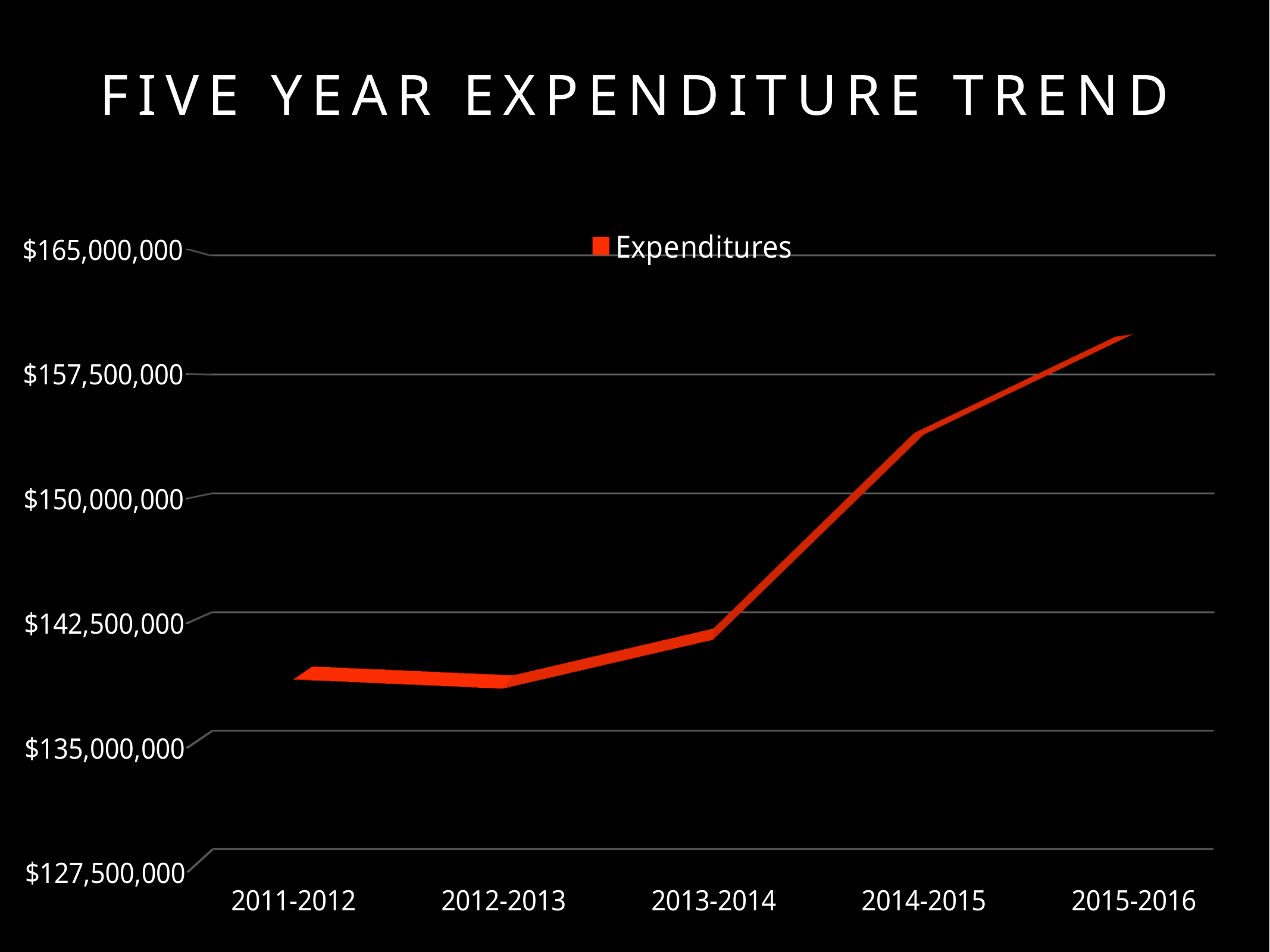
How many series does the legend list? 1 What is the title of the chart? FIVE YEAR EXPENDITURE TREND Which fiscal year has the highest expenditure? 2015-2016 What is the name of the series shown in the legend? Expenditures Do expenditures generally rise or fall from 2012-2013 to 2015-2016? rise Is the expenditure for 2014-2015 greater or less than $150,000,000? greater What kind of chart is shown on the slide? line chart Is the expenditure for 2012-2013 greater or less than $135,000,000? greater Is the expenditure for 2011-2012 greater or less than $142,500,000? less How many fiscal years are plotted on the x axis? 5 Which is larger, the expenditure for 2013-2014 or for 2014-2015? 2014-2015